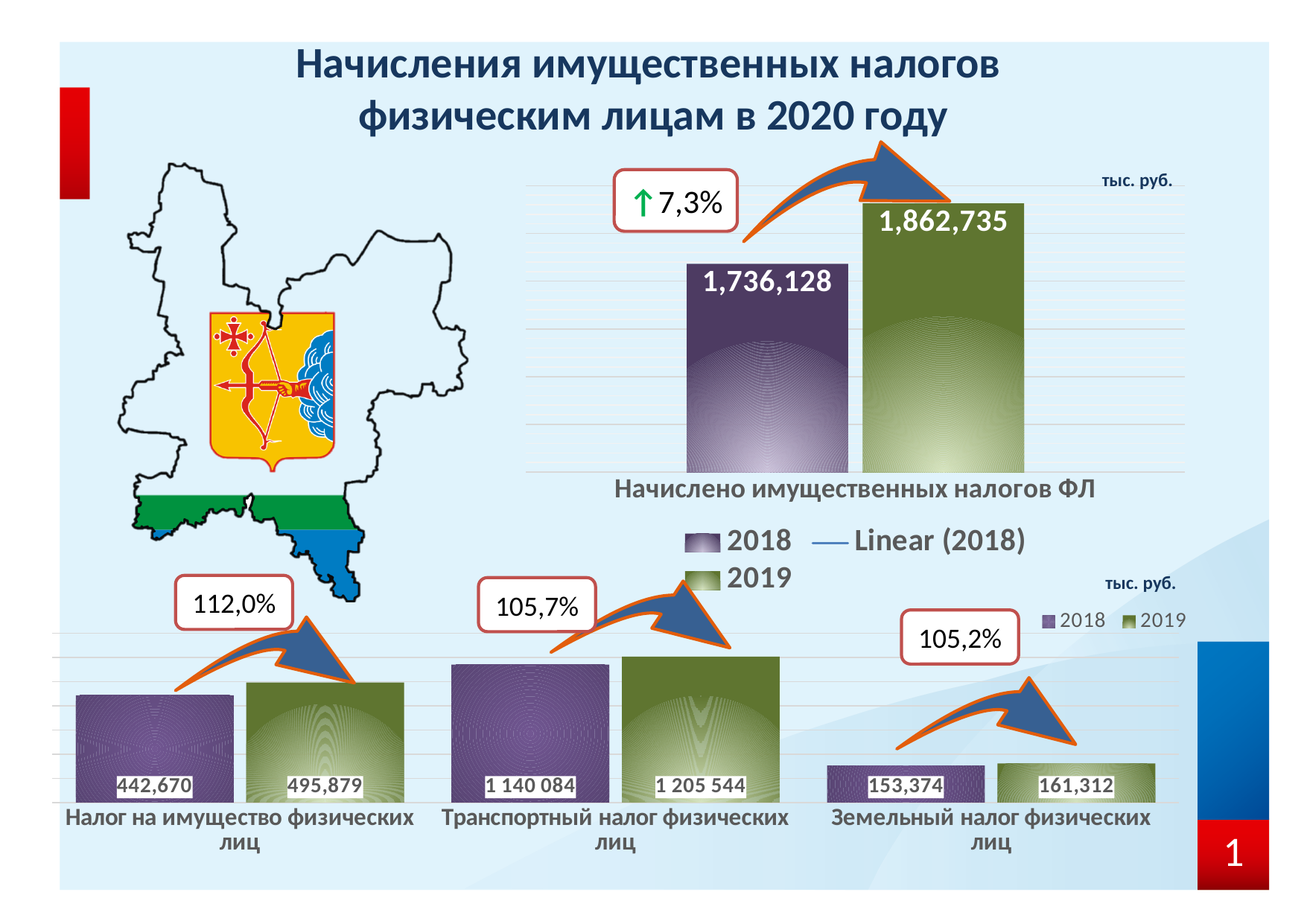
In the top chart, what is the difference between the 2019 and 2018 values? 126,607 In the top chart, how many entries does the legend list? 3 In the bottom chart, what is the 2019 value for 'Земельный налог физических лиц'? 161,312 In the bottom chart, which category has the lowest 2018 value? Земельный налог физических лиц In the top chart, what is the value for 2019 in 'Начислено имущественных налогов ФЛ'? 1,862,735 In the bottom chart, what is the difference between the 2019 and 2018 values for 'Налог на имущество физических лиц'? 53,209 In the bottom chart, what is the 2018 value for 'Транспортный налог физических лиц'? 1 140 084 In the bottom chart, what is the 2019 value for 'Налог на имущество физических лиц'? 495,879 In the bottom chart, which category has the highest 2019 value? Транспортный налог физических лиц In the top chart, what is the value for 2018 in 'Начислено имущественных налогов ФЛ'? 1,736,128 What kind of chart is the bottom chart? Bar chart In the bottom chart, how many categories are shown on the x axis? 3